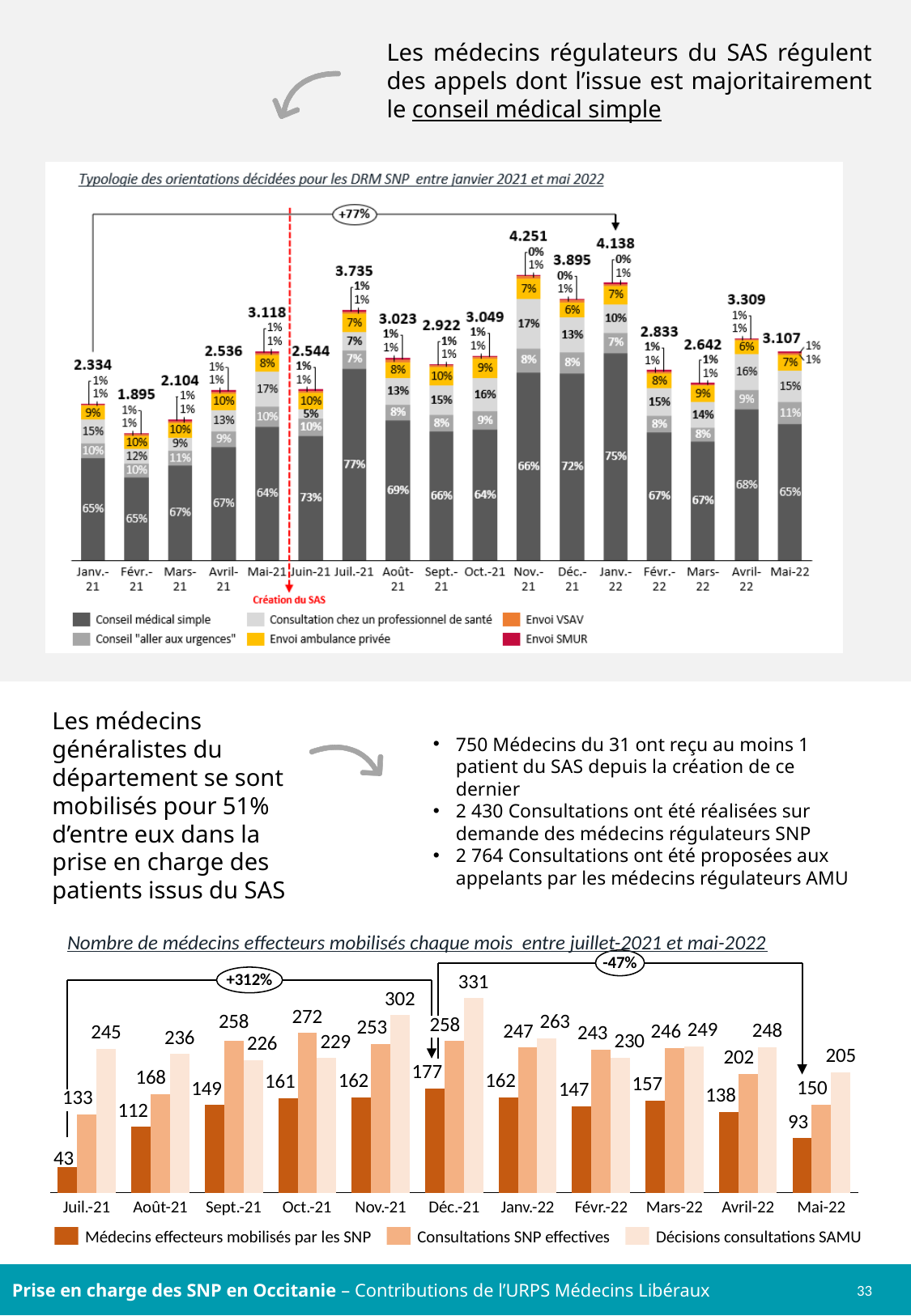
In the top chart, what percentage of orientations in Juil.-21 were 'Conseil médical simple'? 77% In the bottom chart, what is the difference between 'Décisions consultations SAMU' and 'Consultations SNP effectives' in Déc.-21? 73 In the bottom chart, what is the value of 'Médecins effecteurs mobilisés par les SNP' for Juil.-21? 43 What type of chart is the bottom chart? Bar chart In the top chart, how many months are shown on the x axis? 17 In the bottom chart (Nombre de médecins effecteurs mobilisés chaque mois), what is the value of 'Décisions consultations SAMU' for Déc.-21? 331 In the top chart, which month has the lowest total of DRM SNP? Févr.-21 In the top chart (Typologie des orientations décidées pour les DRM SNP), what is the total number of DRM SNP shown for Nov.-21? 4.251 In the bottom chart, which month has the highest value for 'Décisions consultations SAMU'? Déc.-21 In the top chart, how many series does the legend list? 6 In the top chart, which month has the highest total of DRM SNP? Nov.-21 In the bottom chart, which is larger in Mars-22: 'Consultations SNP effectives' or 'Décisions consultations SAMU'? Décisions consultations SAMU